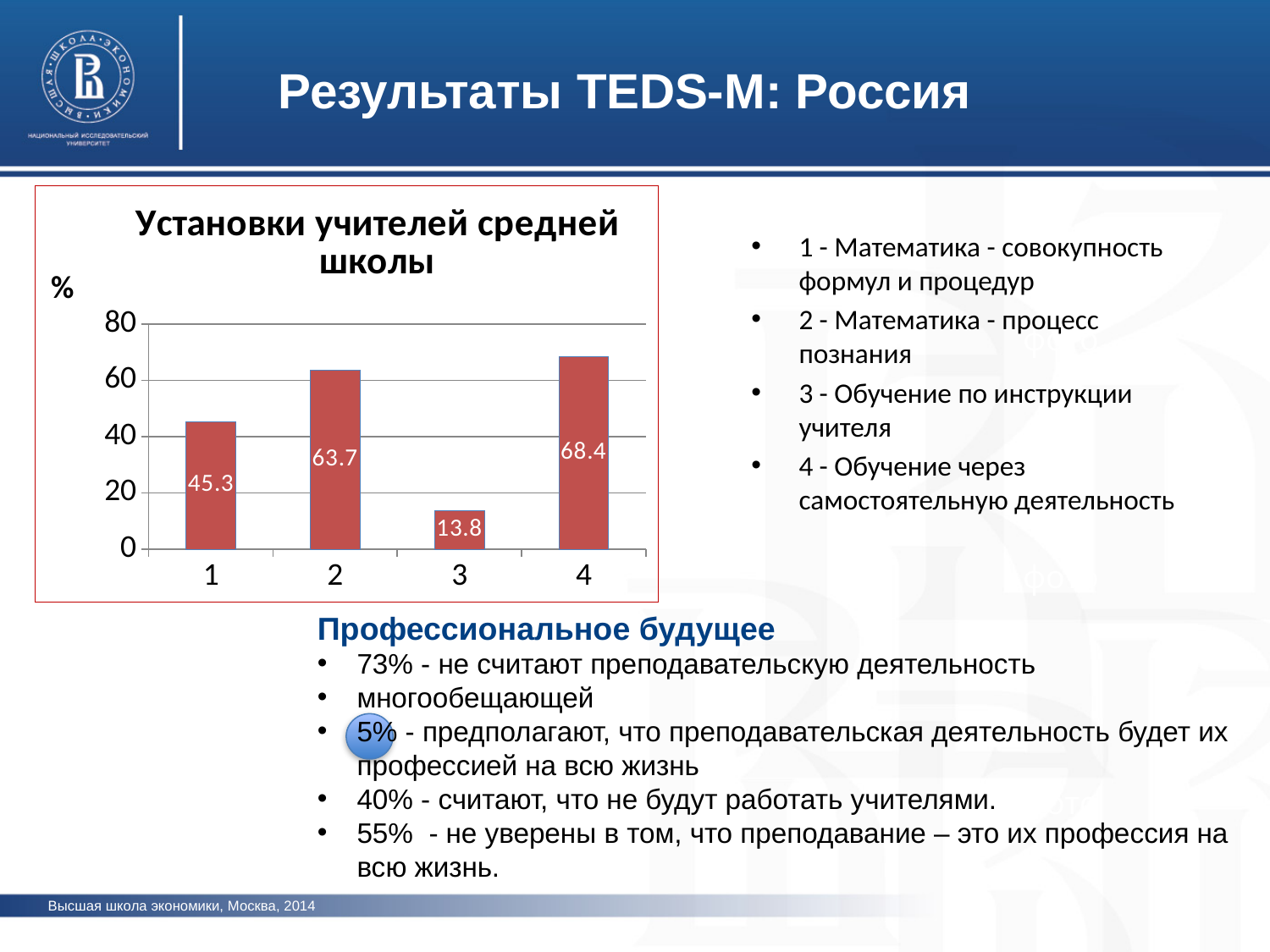
What is the difference between the values for category 4 and category 3? 54.6 Which category has the lowest value in the chart? 3 What is the value for category 1 in the chart? 45.3 Which category has the highest value in the chart? 4 What is the difference between the values for category 2 and category 1? 18.4 Is the value for category 1 greater or less than 40? greater How many categories are shown on the x axis of the chart? 4 What type of chart is shown on the slide? bar chart What is the value for category 3 in the chart? 13.8 What is the value for category 4 in the chart? 68.4 Which is larger, the value for category 1 or the value for category 2? category 2 What is the value for category 2 in the chart? 63.7